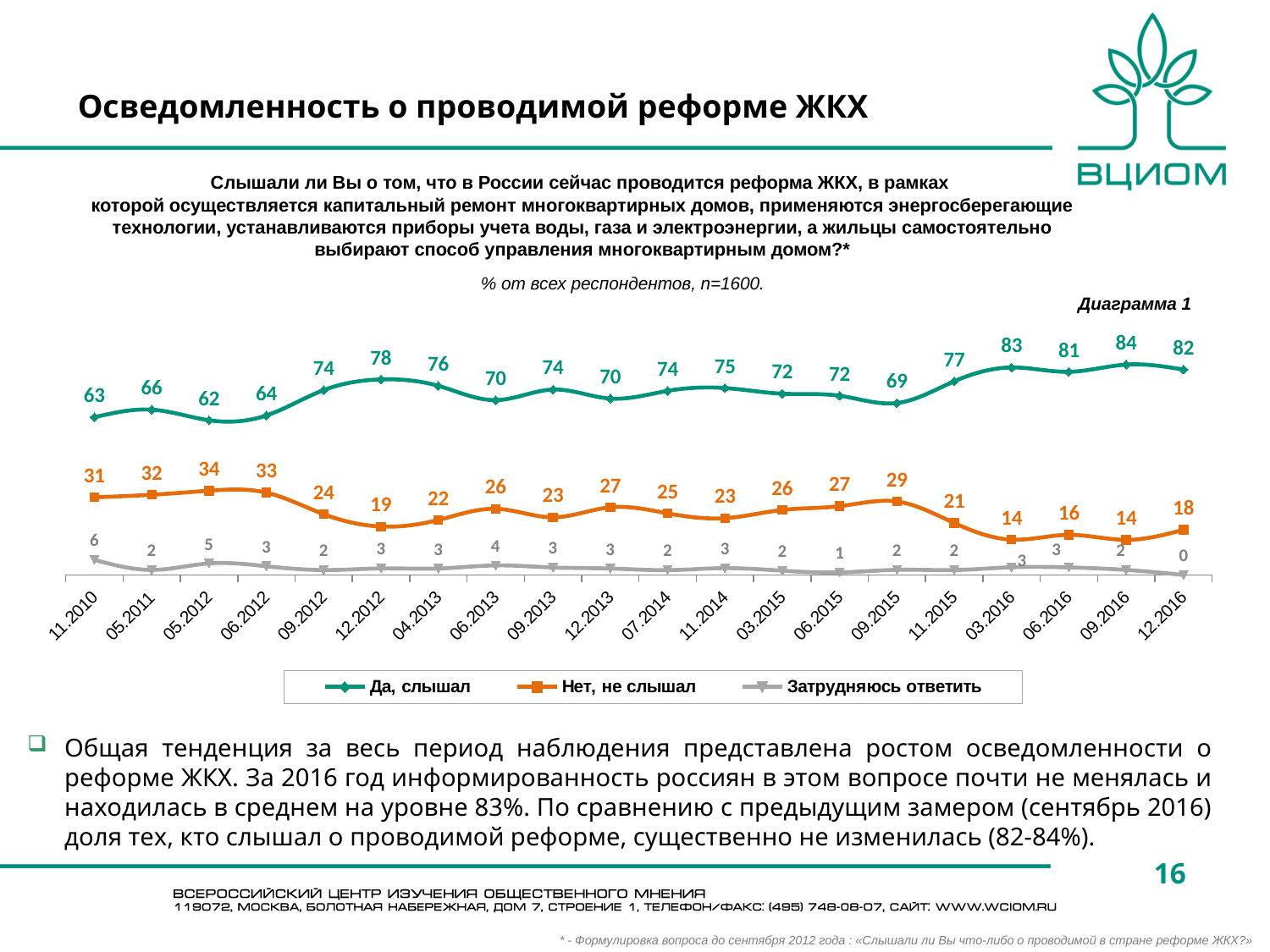
What type of chart is shown on the slide? line chart What is the label of the series drawn in orange? Нет, не слышал What is the value for "Нет, не слышал" in 11.2010? 31 How many series does the legend list? 3 What is the difference between the "Да, слышал" and "Нет, не слышал" values in 12.2016? 64 What is the value for "Затрудняюсь ответить" in 12.2016? 0 In which period does the "Да, слышал" series have its lowest value? 05.2012 Does the "Нет, не слышал" series generally rise or fall from 11.2010 to 12.2016? fall In which period does the "Да, слышал" series reach its highest value? 09.2016 How many time points are plotted on the x axis? 20 Which is larger in 09.2015: the value for "Нет, не слышал" or the value for "Затрудняюсь ответить"? Нет, не слышал What is the value for "Да, слышал" in 12.2016? 82